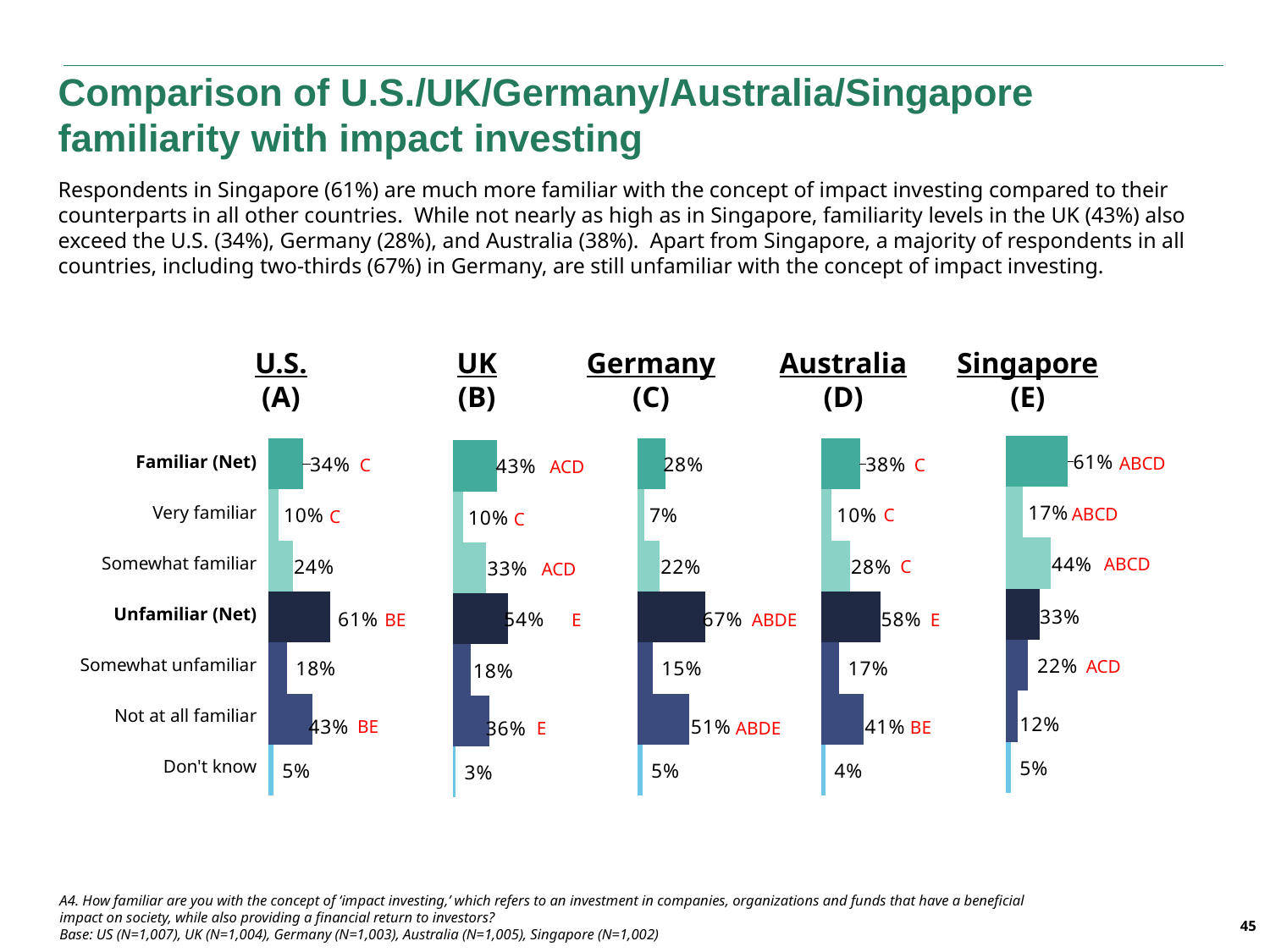
In the Singapore chart, what percentage of respondents are Familiar (Net) with impact investing? 61% In the Germany chart, what is the value for Unfamiliar (Net)? 67% What is the difference between the Unfamiliar (Net) value in the Germany chart and the Unfamiliar (Net) value in the Singapore chart? 34% Across the five country charts, which country has the highest Familiar (Net) value? Singapore In the UK chart, what is the value for Don't know? 3% In the Australia chart, what is the value for Somewhat familiar? 28% How many response categories are shown in each country chart? 7 In the U.S. chart, what percentage of respondents are Not at all familiar? 43% Across the five country charts, which country has the lowest Very familiar value? Germany How many country charts are shown on the slide? 5 Which is larger: the Not at all familiar value in the UK chart or the Not at all familiar value in the Australia chart? Australia What type of chart is used to show the familiarity results for each country? Bar chart